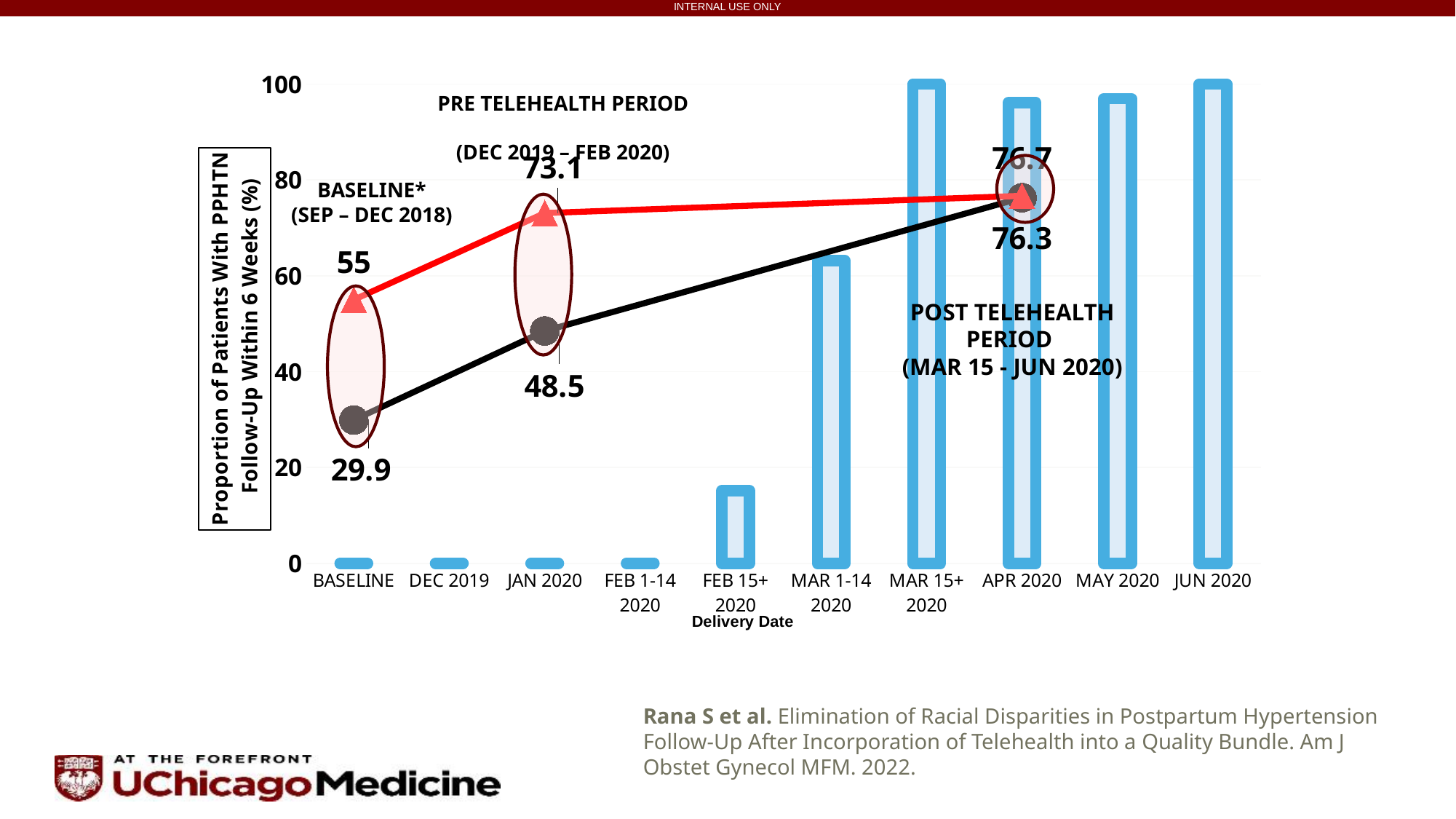
At JAN 2020, which line has the higher value, the red line or the black line? the red line Is the bar for FEB 15+ 2020 greater or less than 20? less What is the value of the red line (triangle markers) at BASELINE? 55 Does the black line rise or fall from BASELINE to APR 2020? rises What is the difference between the red line and the black line values at BASELINE? 25.1 What is the value of the red line (triangle markers) at APR 2020? 76.7 What is the title of the x axis? Delivery Date How many categories are shown on the x axis? 10 By how much does the black line value increase from BASELINE to JAN 2020? 18.6 What is the value of the black line (circle markers) at BASELINE? 29.9 What is the value of the black line (circle markers) at JAN 2020? 48.5 Is the bar for MAR 1-14 2020 greater or less than 40? greater